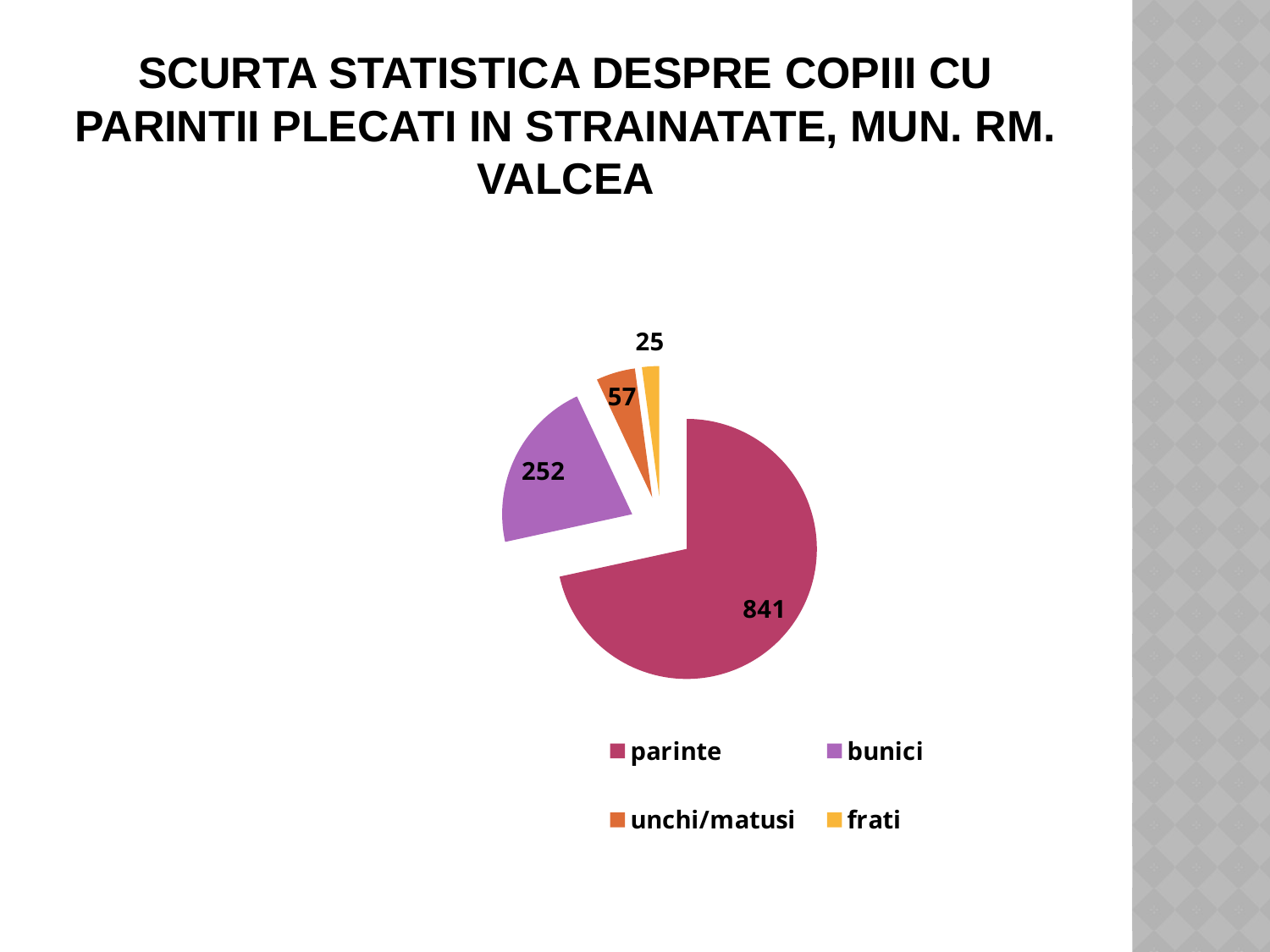
How many categories does the legend list? 4 What is the value for unchi/matusi? 57 What is the value for frati? 25 What is the difference between the values for parinte and bunici? 589 Which is larger, the value for bunici or the value for unchi/matusi? bunici What is the value for bunici? 252 What is the total of all slices in the pie chart? 1175 Which category has the smallest slice? frati Which category has the largest slice? parinte What kind of chart is shown on the slide? pie chart What is the difference between the values for unchi/matusi and frati? 32 What is the value for parinte? 841